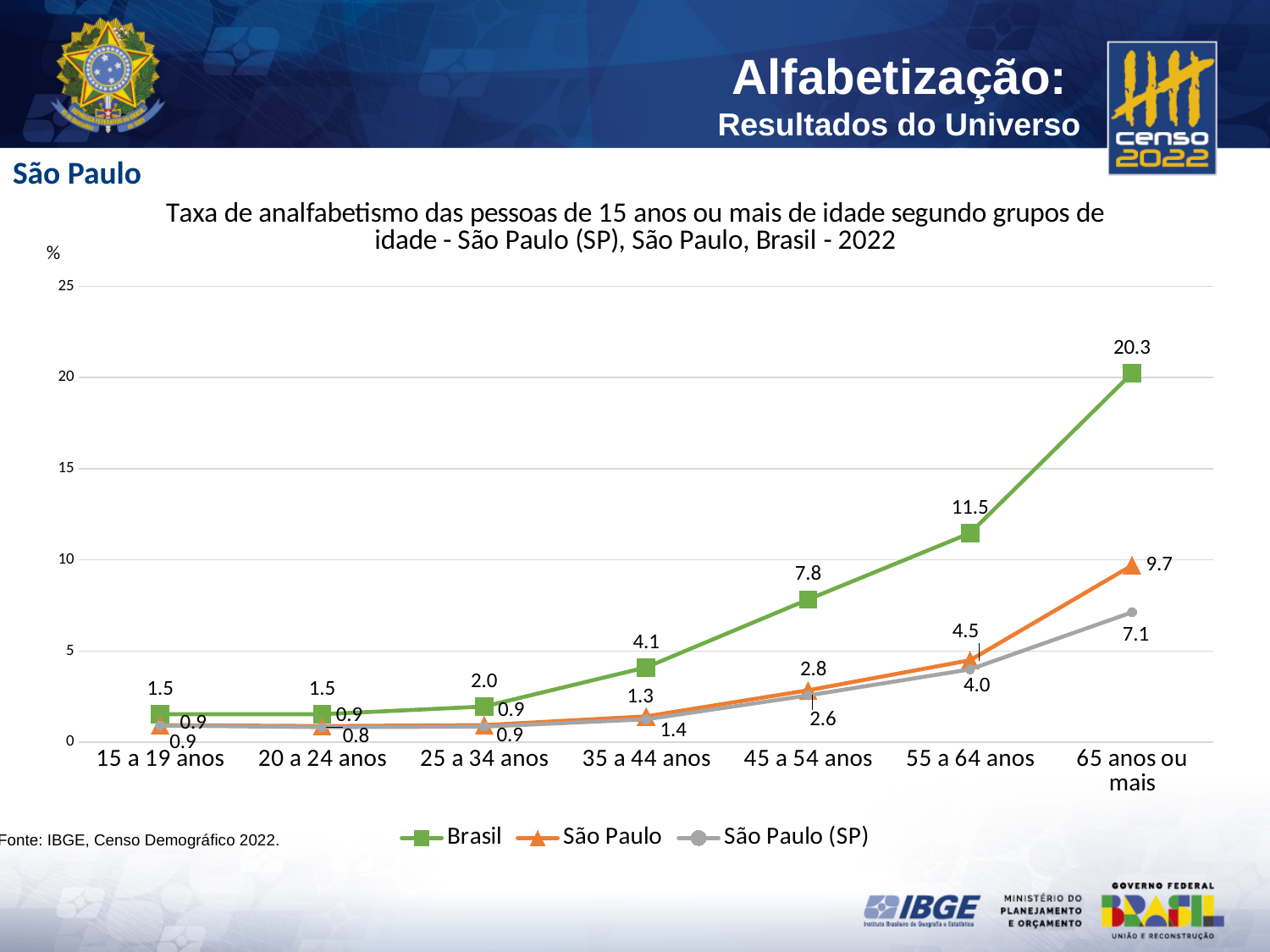
What is the value for São Paulo in the '65 anos ou mais' age group? 9.7 What is the difference between the Brasil and São Paulo values in the '65 anos ou mais' age group? 10.6 Is the value for Brasil in the '55 a 64 anos' age group greater or less than 10? greater Which age group has the highest value for Brasil? 65 anos ou mais How many series does the legend list? 3 What kind of chart is shown on the slide? line chart What is the value for São Paulo (SP) in the '55 a 64 anos' age group? 4.0 What is the value for Brasil in the '65 anos ou mais' age group? 20.3 How many age groups are shown on the x axis? 7 In the '45 a 54 anos' age group, which is larger: São Paulo or São Paulo (SP)? São Paulo What is the value for Brasil in the '45 a 54 anos' age group? 7.8 Do the Brasil values rise or fall as the age groups increase along the x axis? rise